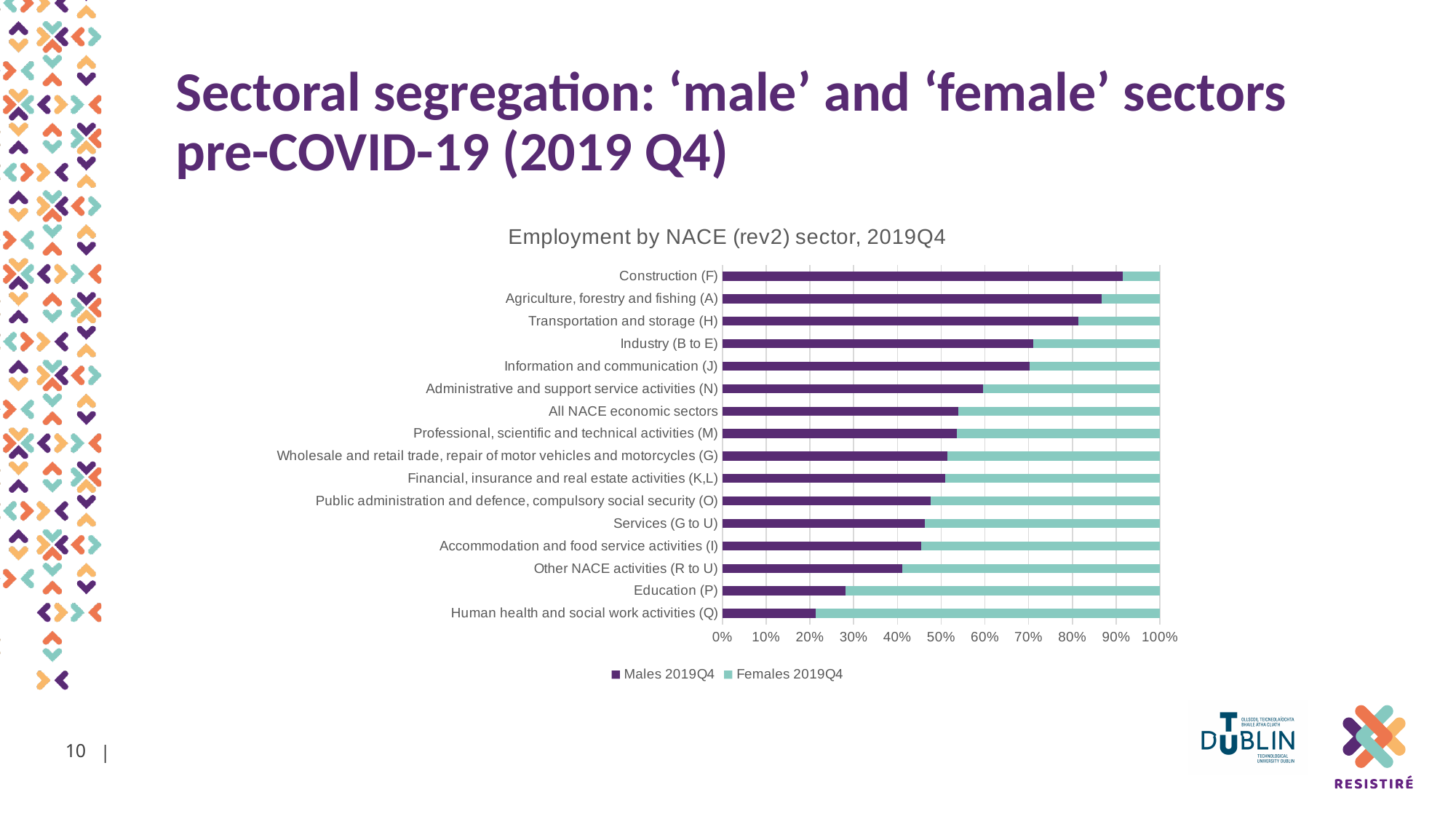
Is the Males 2019Q4 share for Education (P) greater or less than 30%? less Which sector has the highest share of Females 2019Q4? Human health and social work activities (Q) How many sectors (categories) are plotted in the chart? 16 What are the two series named in the legend? Males 2019Q4 and Females 2019Q4 Is the Males 2019Q4 share for Construction (F) greater or less than 90%? greater What is the title of the chart? Employment by NACE (rev2) sector, 2019Q4 Which sector has the lowest share of Males 2019Q4? Human health and social work activities (Q) How many series does the legend list? 2 Which has a larger Males 2019Q4 share: Transportation and storage (H) or Services (G to U)? Transportation and storage (H) What kind of chart is shown on the slide? Stacked bar chart Which sector has the highest share of Males 2019Q4? Construction (F)